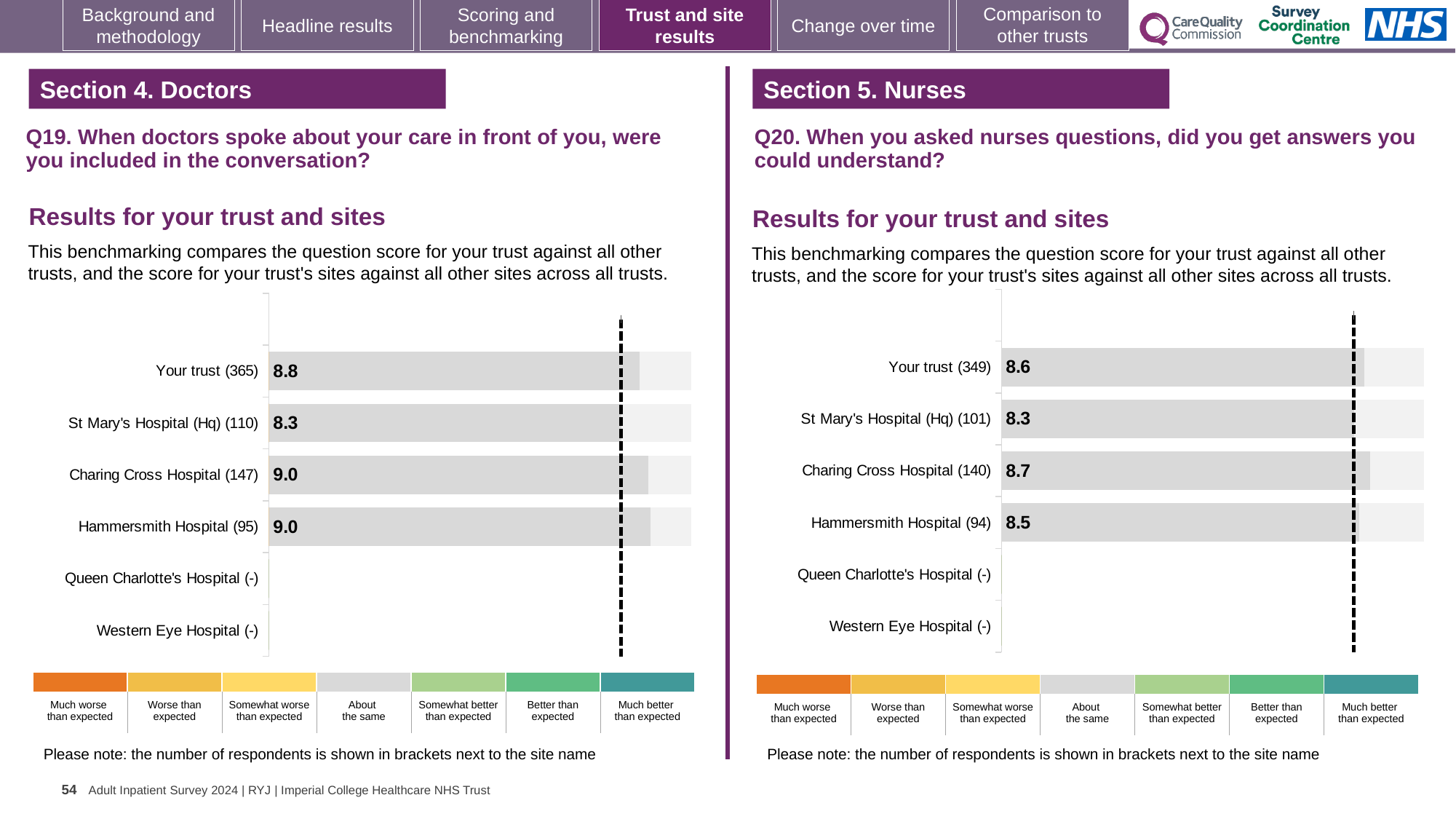
In the Q19 chart on the left, what is the difference between the scores for Charing Cross Hospital (147) and St Mary's Hospital (Hq) (110)? 0.7 In the Q20 chart on the right, which site has the highest score? Charing Cross Hospital (140) In the Q19 chart on the left, what is the score for Hammersmith Hospital (95)? 9.0 In the Q20 chart on the right, what is the score for Charing Cross Hospital (140)? 8.7 In the Q20 chart on the right, which has the higher score, Charing Cross Hospital (140) or St Mary's Hospital (Hq) (101)? Charing Cross Hospital (140) In the Q20 chart on the right, what is the score for Your trust (349)? 8.6 In the Q20 chart on the right, what is the difference between the scores for Your trust (349) and Hammersmith Hospital (94)? 0.1 In the Q19 chart on the left, what is the score for Your trust (365)? 8.8 In the Q19 chart on the left, which site with a score shown has the lowest score? St Mary's Hospital (Hq) (110) In the Q19 chart on the left, what is the score for St Mary's Hospital (Hq) (110)? 8.3 What kind of chart is used for the Q20 results on the right? Bar chart How many site rows are listed in the Q19 chart on the left, including those with no score? 6